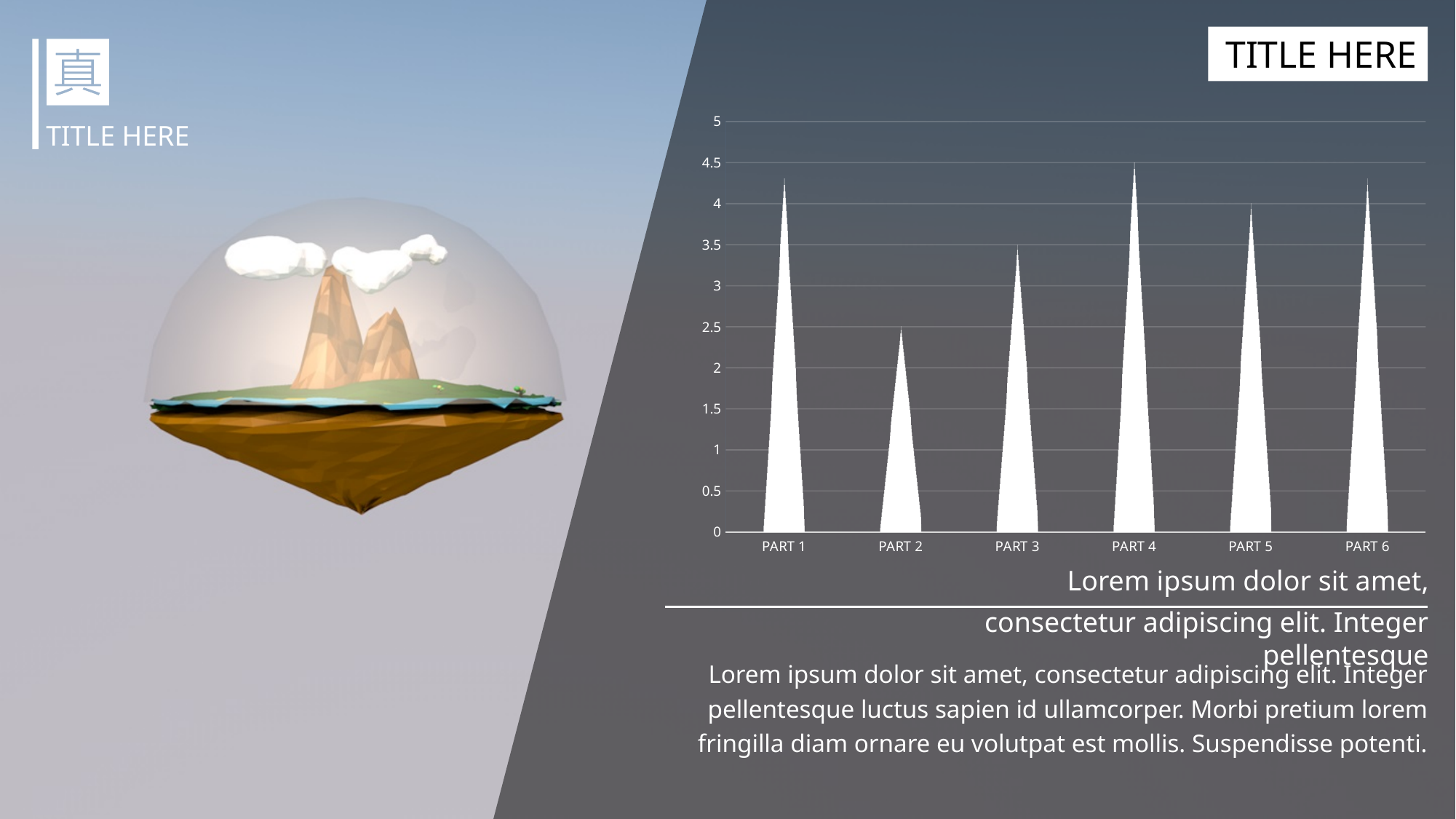
Is the value for PART 6 greater or less than 3.5? greater Is the value for PART 3 greater or less than 3? greater Is the value for PART 4 greater or less than 4? greater What is the label of the first category on the x axis? PART 1 Which is larger, the value for PART 3 or the value for PART 4? PART 4 Which category has the lowest value on the chart? PART 2 Which is larger, the value for PART 2 or the value for PART 3? PART 3 What kind of chart is shown on the slide? bar chart How many categories are plotted on the chart? 6